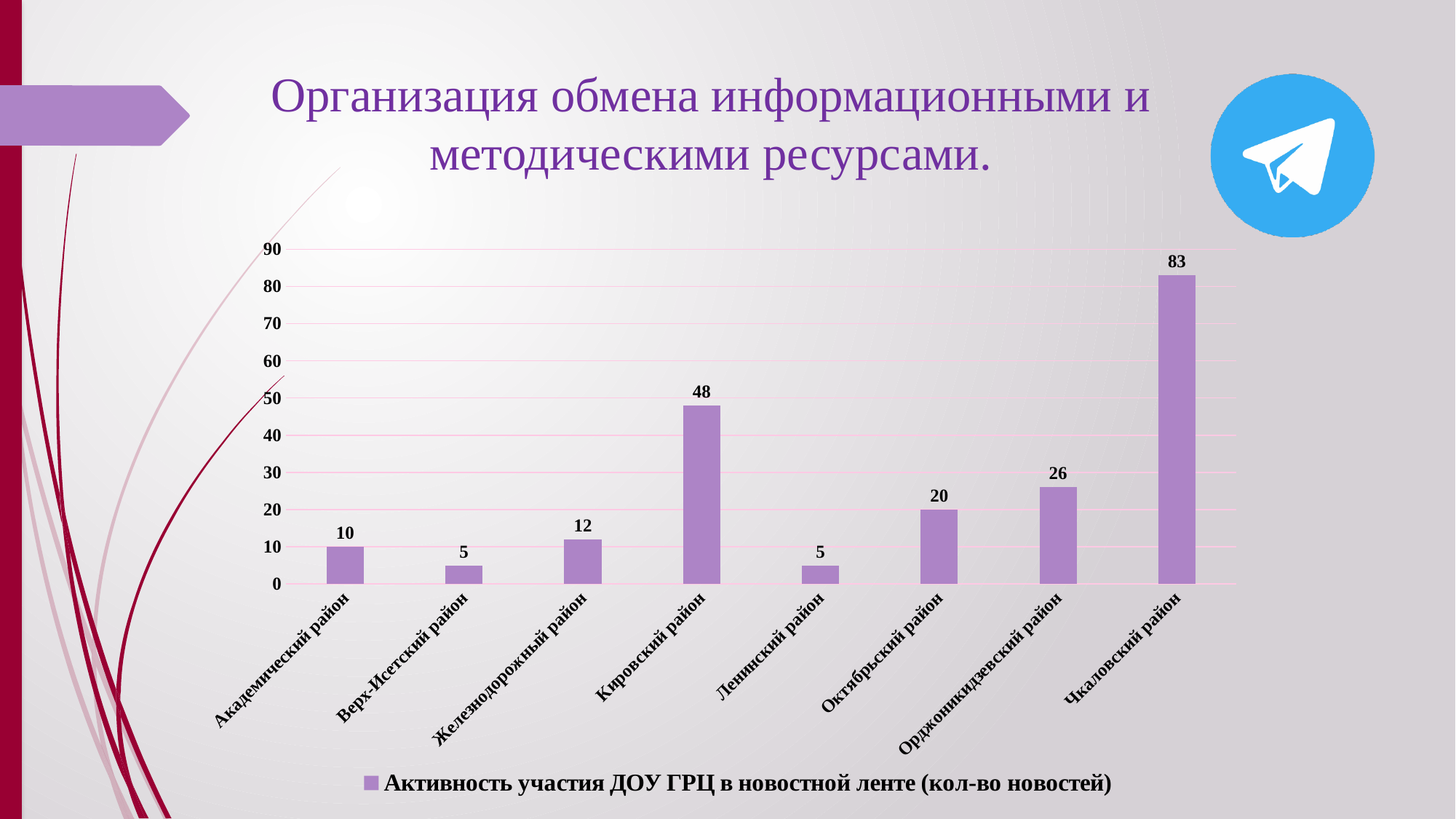
Which is larger, the value for Октябрьский район or the value for Железнодорожный район? Октябрьский район How many series does the legend list? 1 What is the value for Орджоникидзевский район? 26 Is the value for Кировский район greater or less than 40? greater What kind of chart is shown on the slide? bar chart What is the legend entry for the series shown? Активность участия ДОУ ГРЦ в новостной ленте (кол-во новостей) How many districts are shown on the x axis? 8 Which district has the highest value? Чкаловский район What is the value for Чкаловский район? 83 What is the value for Кировский район? 48 What is the difference between the values for Орджоникидзевский район and Октябрьский район? 6 What is the difference between the values for Чкаловский район and Кировский район? 35